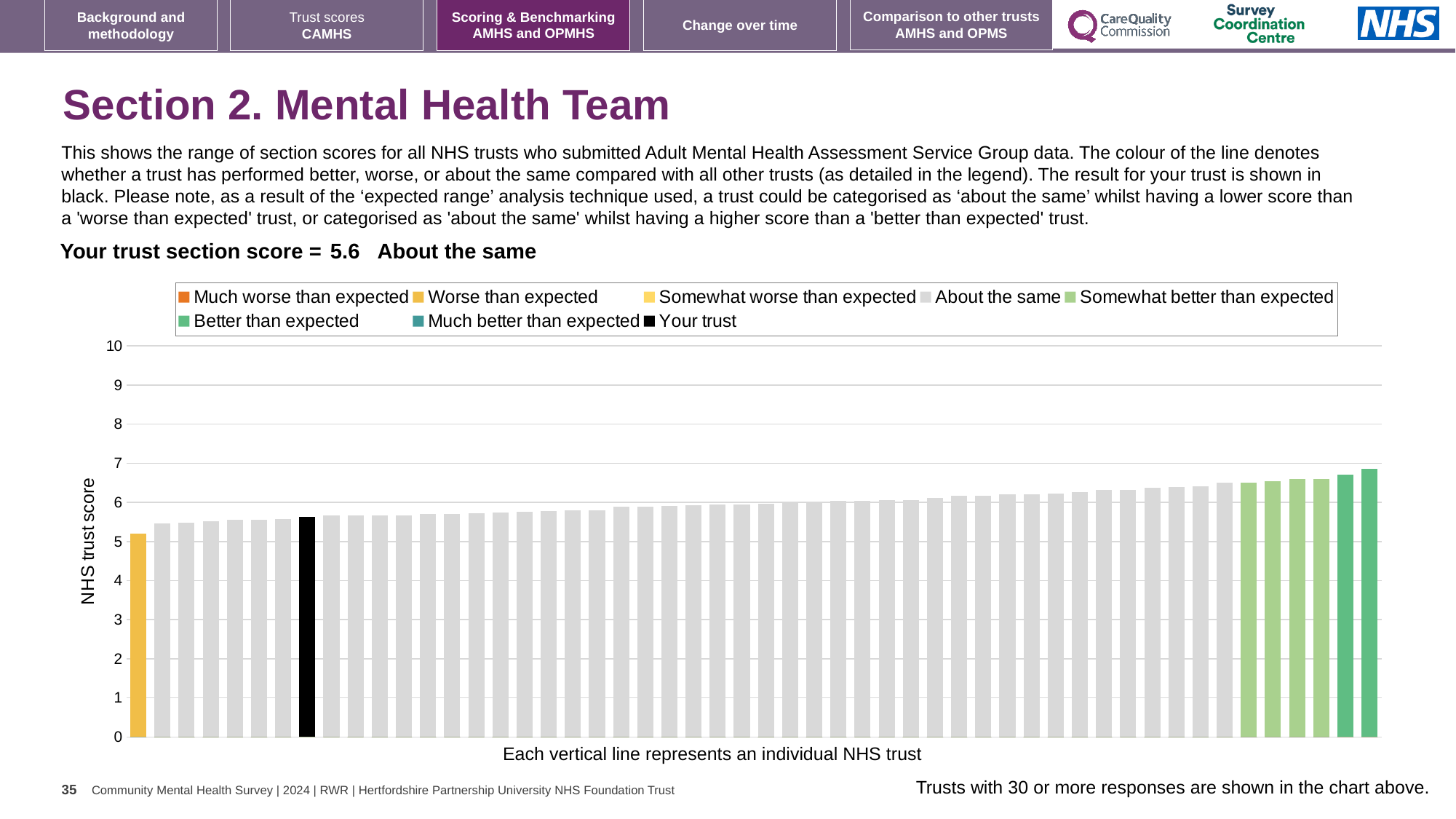
How many entries does the chart legend list? 8 What colour is the bar for your trust in the chart? black Which is taller, the leftmost bar or the bar for your trust? the bar for your trust What kind of chart is shown on the slide? bar chart What is the label on the vertical axis of the chart? NHS trust score What is the section score for your trust? 5.6 Do the bar values rise or fall from left to right along the x axis? rise Is the value of the tallest bar (rightmost) greater or less than 6? greater Is the value for your trust greater or less than 6? less Is the value of the tallest bar (rightmost) greater or less than 7? less